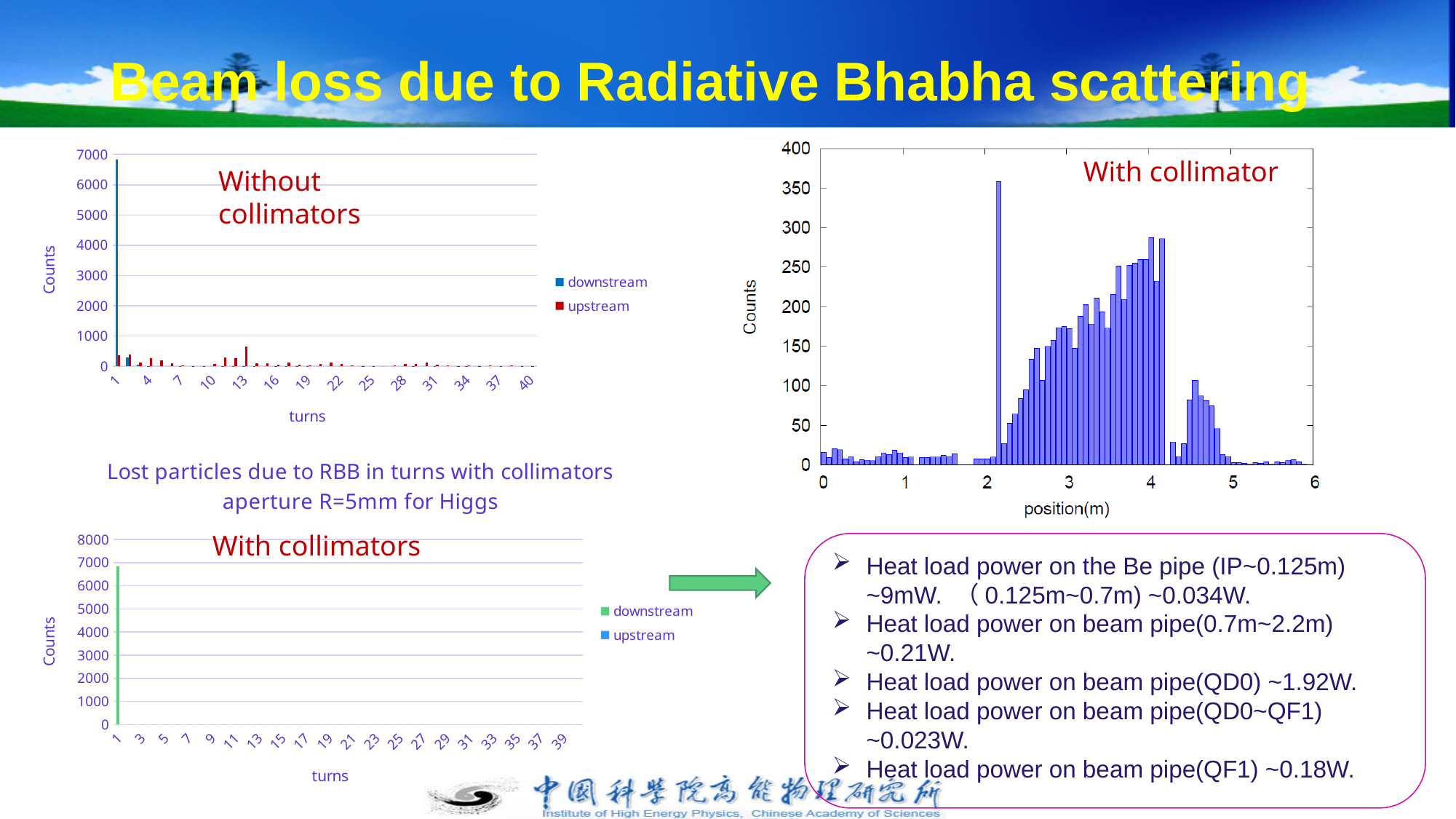
In the 'Without collimators' chart at the top left, is the downstream value at turn 1 greater or less than 6000? greater In the 'With collimator' chart on the right, is the tallest bar (near position 2.1 m) greater or less than 350? greater In the 'With collimator' chart on the right, are the counts at position 1 m greater or less than 50? less In the 'With collimator' chart on the right, what is the label of the x axis? position(m) In the 'Without collimators' chart at the top left, how many series does the legend list? 2 In the 'Without collimators' chart at the top left, what kind of chart is it? bar chart In the 'Without collimators' chart at the top left, which series has the tallest bar? downstream In the 'With collimators' chart at the bottom left, what is the highest value shown on the y axis? 8000 In the 'With collimators' chart at the bottom left, how many series does the legend list? 2 In the 'Without collimators' chart at the top left, what is the label of the x axis? turns